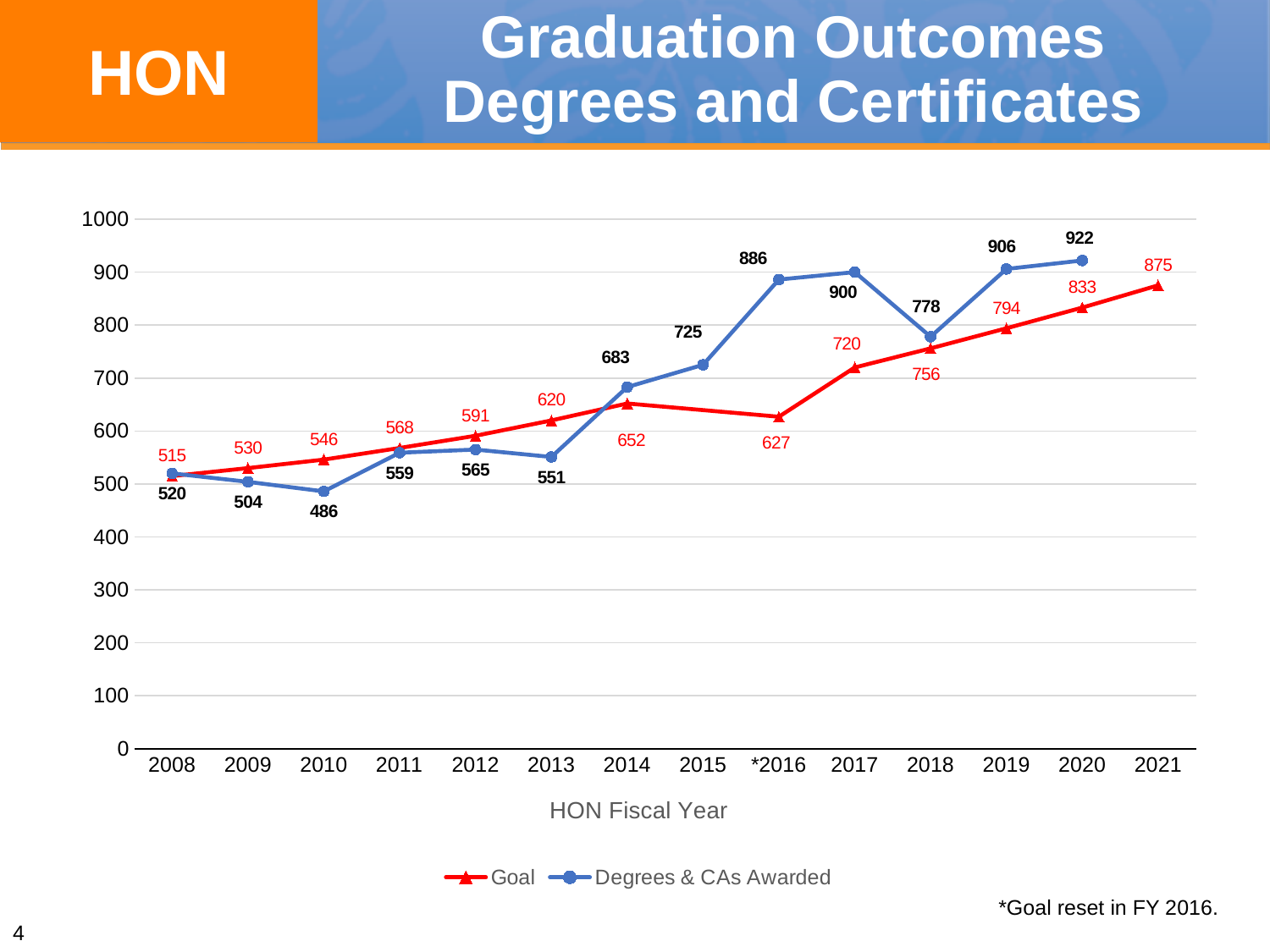
In which year is the Degrees & CAs Awarded value lowest? 2010 What is the value for Degrees & CAs Awarded in 2010? 486 Which is larger in 2018, the Goal or Degrees & CAs Awarded? Degrees & CAs Awarded How many series does the legend list? 2 Which is larger in 2013, the Goal or Degrees & CAs Awarded? Goal What is the value for Degrees & CAs Awarded in 2020? 922 What is the difference between Degrees & CAs Awarded and the Goal in 2017? 180 What is the label of the x axis? HON Fiscal Year What kind of chart is shown on the slide? Line chart What is the Goal value for *2016? 627 What is the Goal value for 2021? 875 In which year is the Degrees & CAs Awarded value highest? 2020